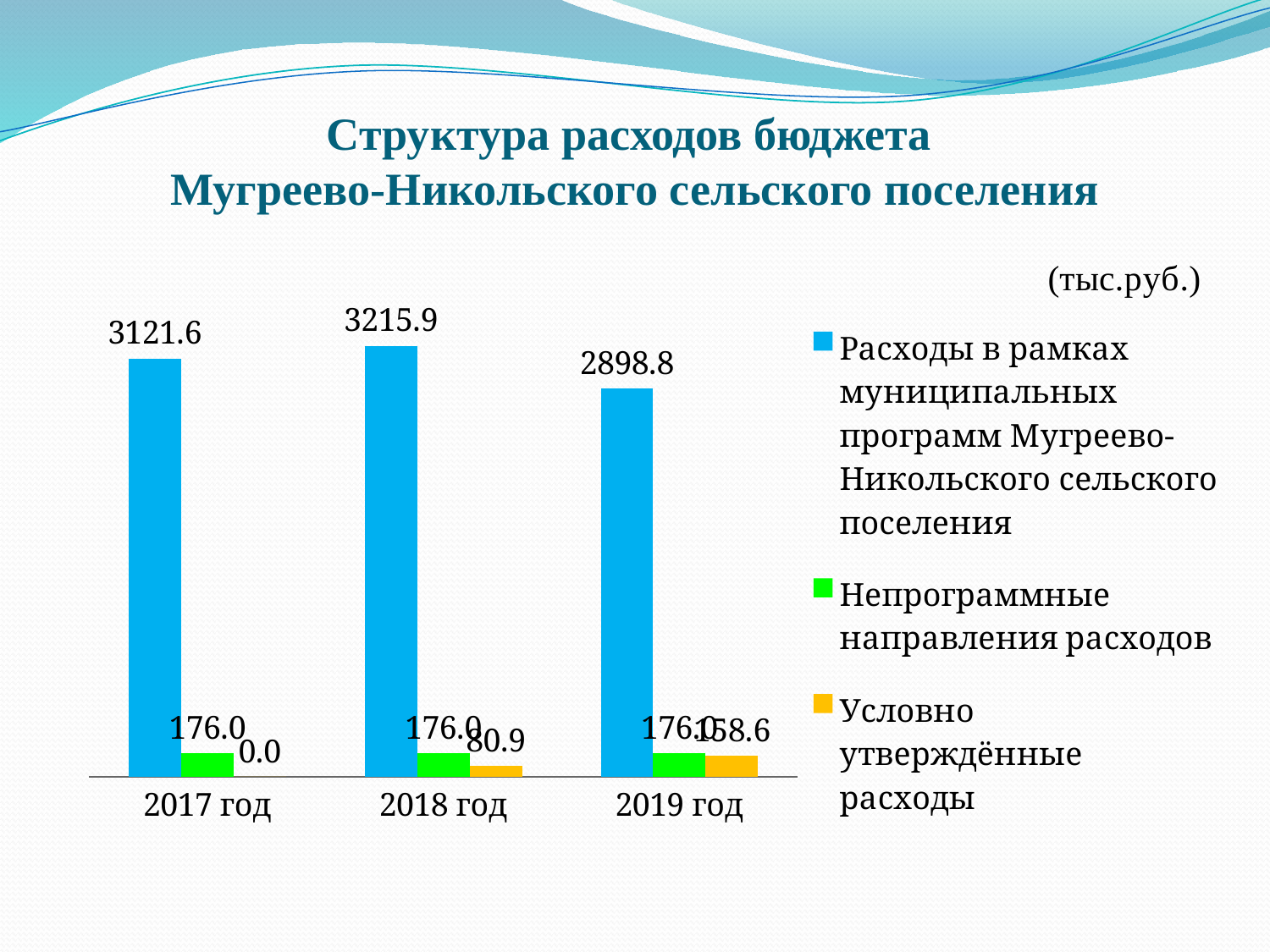
What is the difference between the 'Расходы в рамках муниципальных программ' values for 2018 год and 2019 год? 317.1 What is the value of 'Расходы в рамках муниципальных программ Мугреево-Никольского сельского поселения' for 2019 год? 2898.8 What is the value of 'Расходы в рамках муниципальных программ Мугреево-Никольского сельского поселения' for 2018 год? 3215.9 How many year categories are shown on the x axis? 3 What is the value of 'Непрограммные направления расходов' for 2017 год? 176.0 How many series does the legend list? 3 In which year is the value of 'Расходы в рамках муниципальных программ Мугреево-Никольского сельского поселения' the highest? 2018 год Which is larger: 'Условно утверждённые расходы' in 2018 год or in 2019 год? 2019 год What is the value of 'Условно утверждённые расходы' for 2018 год? 80.9 What type of chart is shown on the slide? bar chart What is the value of 'Условно утверждённые расходы' for 2017 год? 0.0 In which year is the value of 'Условно утверждённые расходы' the lowest? 2017 год